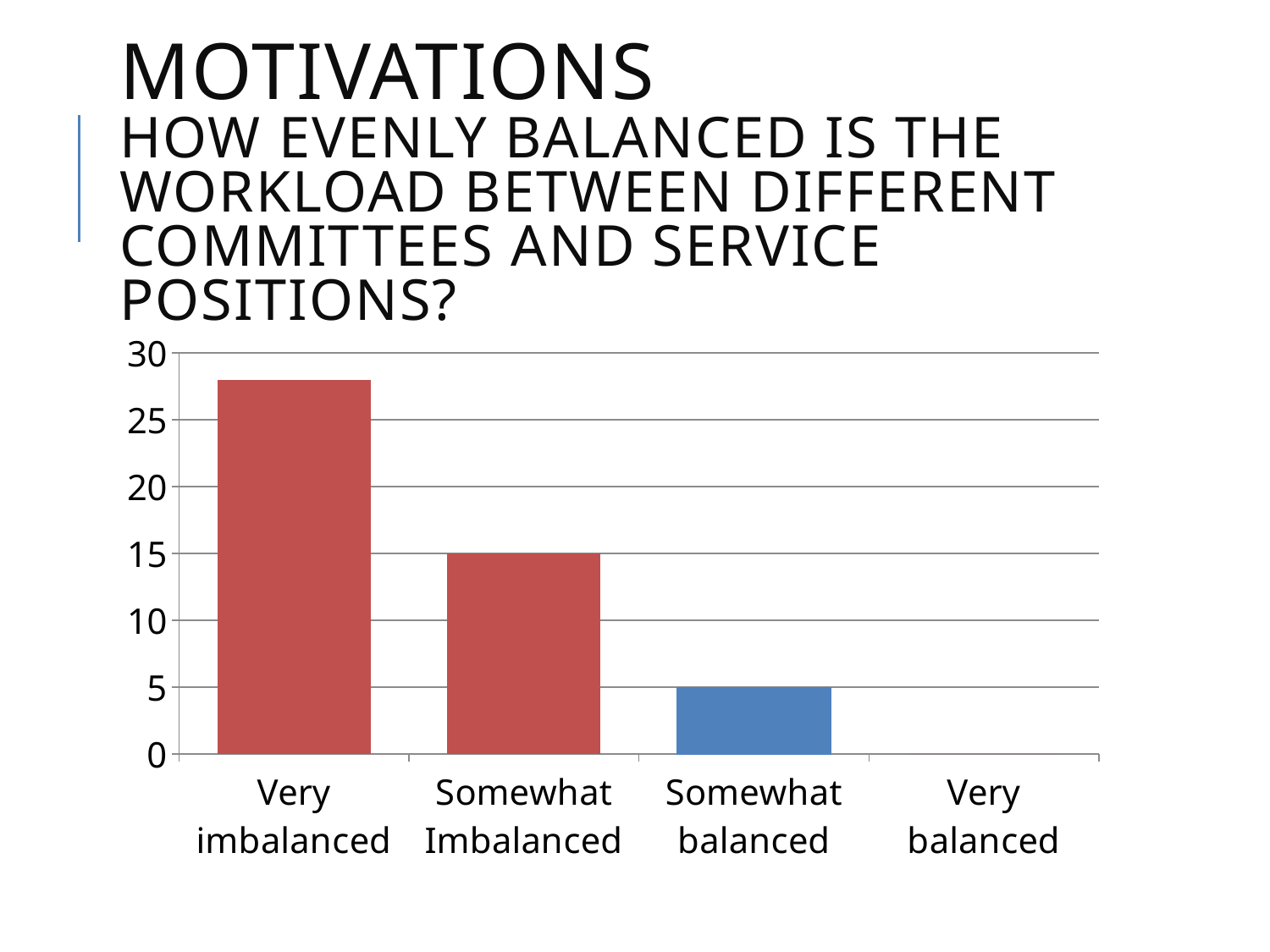
Which category has the highest value in the chart? Very imbalanced What is the value for Somewhat Imbalanced? 15 Is the value for Very imbalanced greater or less than 30? less What is the difference between the values for Somewhat Imbalanced and Somewhat balanced? 10 What is the value for Somewhat balanced? 5 What is the value for Very balanced? 0 Which category has the lowest value in the chart? Very balanced Do the values rise or fall moving from left to right along the x axis? fall Is the value for Very imbalanced greater or less than 25? greater What kind of chart is shown on the slide? bar chart How many categories are shown on the x axis of the chart? 4 Which is larger, the value for Very imbalanced or the value for Somewhat Imbalanced? Very imbalanced